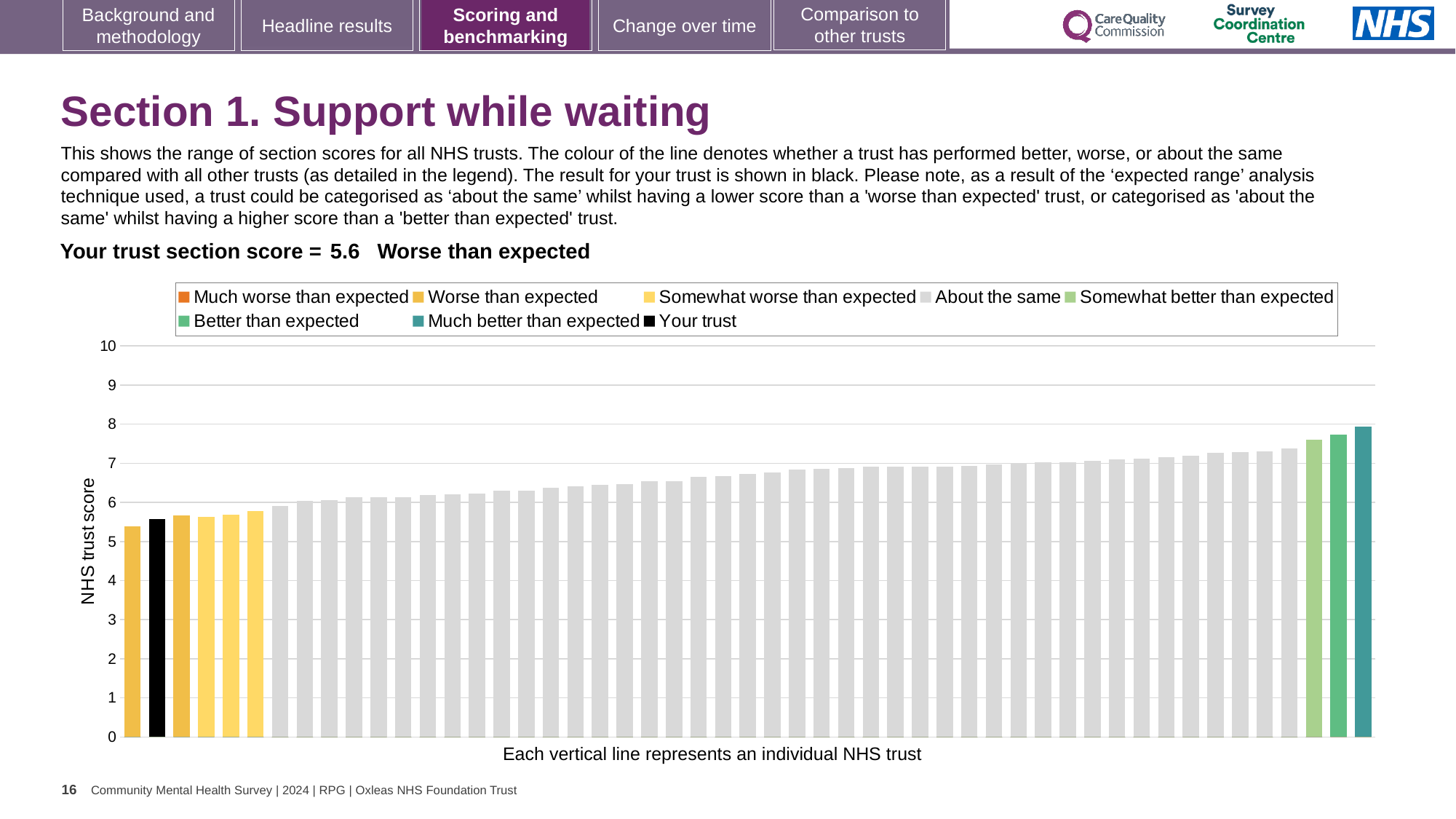
Which legend category does the tallest bar on the chart belong to? Much better than expected Is the value of the tallest bar (rightmost) greater or less than 7? greater What is the section score for your trust shown on the slide? 5.6 What does each vertical line on the chart represent, according to the caption below the x axis? an individual NHS trust Is the value of the shortest bar (leftmost) greater or less than 5? greater Which performance category is your trust placed in for this section? Worse than expected Is the value of the black bar (your trust) greater or less than 6? less How many bars are coloured black (Your trust)? 1 Do the bar values rise or fall from left to right along the x axis? rise What is the label on the vertical axis of the chart? NHS trust score What kind of chart is shown on the slide? bar chart How many entries does the chart legend list? 8